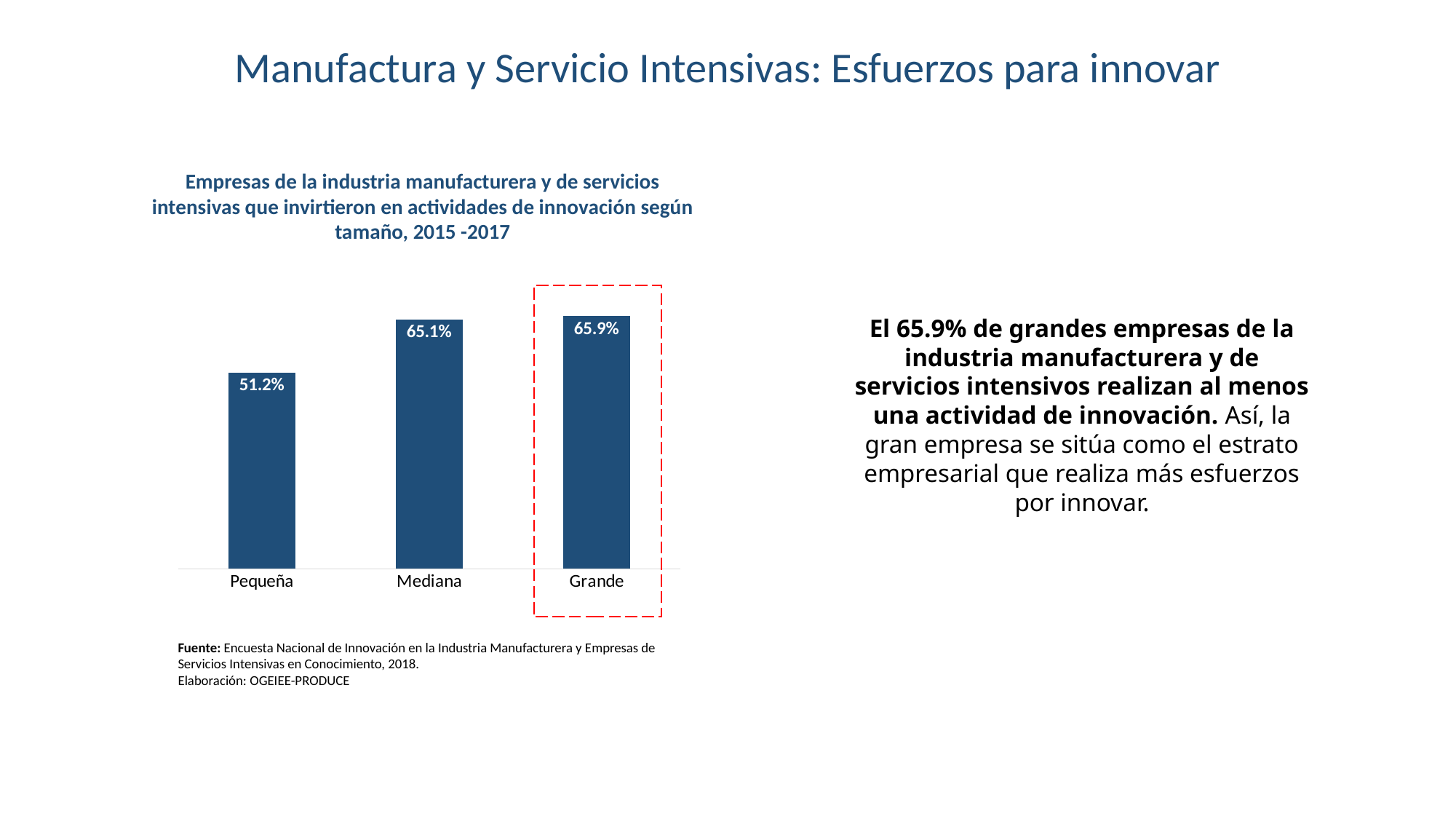
What is the value for Grande? 65.9% What is the difference between the values for Grande and Pequeña? 14.7% What is the difference between the values for Mediana and Pequeña? 13.9% Which is larger, the value for Mediana or the value for Pequeña? Mediana Which category has the highest value? Grande What is the value for Pequeña? 51.2% How many categories are shown in the chart? 3 What is the value for Mediana? 65.1% Which category has the lowest value? Pequeña Which category is highlighted with a red dashed box? Grande Do the values rise or fall from Pequeña to Grande along the x axis? Rise What kind of chart is shown on the slide? Bar chart